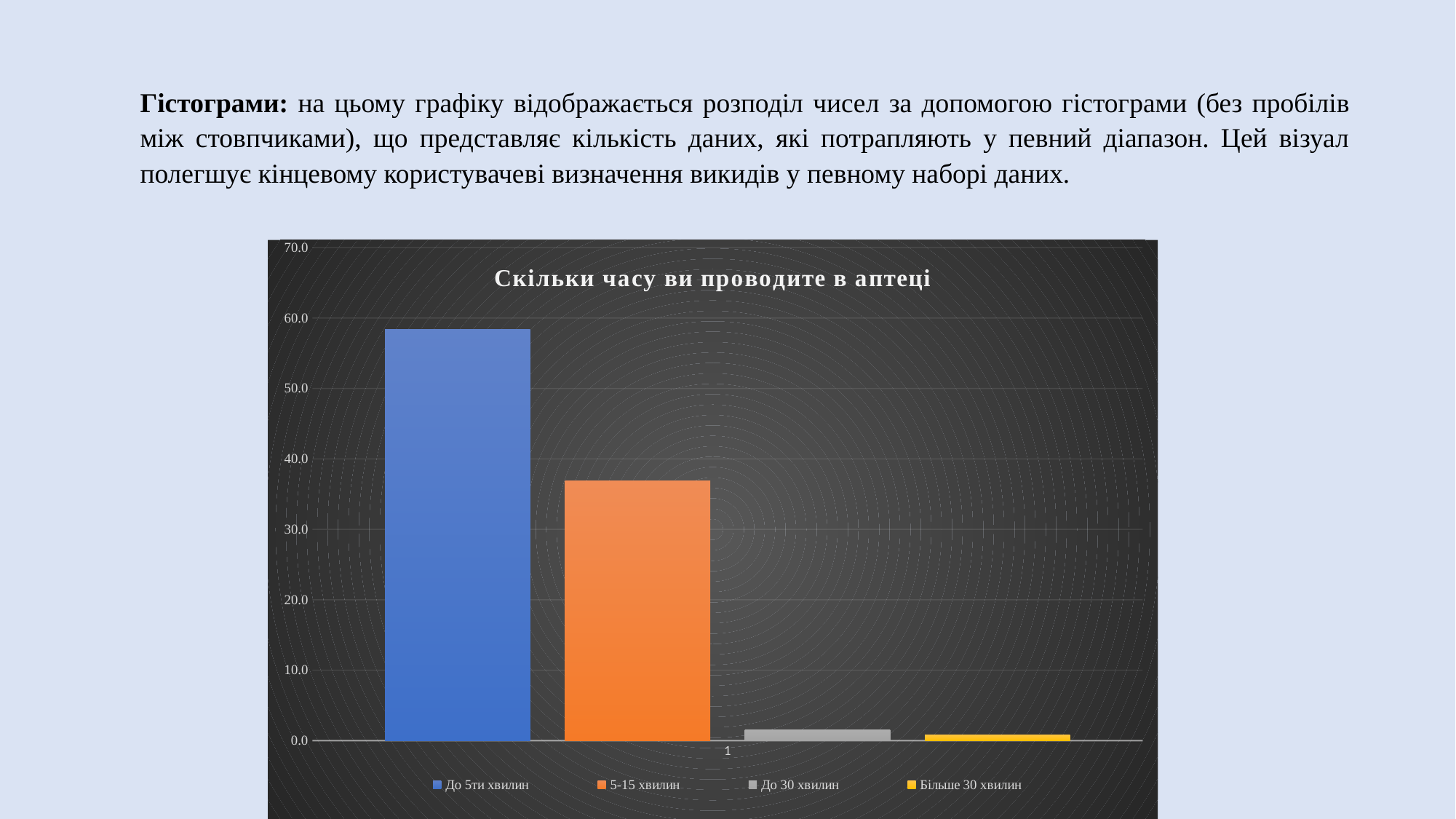
Which is larger, the value for До 5ти хвилин or the value for 5-15 хвилин? До 5ти хвилин What is the title of the chart? Скільки часу ви проводите в аптеці Is the value for 5-15 хвилин greater or less than 40.0? less How many series does the legend list? 4 Which series has the lowest value? Більше 30 хвилин Is the value for До 5ти хвилин greater or less than 50.0? greater How many bars are plotted in the chart? 4 Is the value for До 30 хвилин greater or less than 10.0? less Which is larger, the value for 5-15 хвилин or the value for До 30 хвилин? 5-15 хвилин Which series has the highest value? До 5ти хвилин What kind of chart is shown on the slide? bar chart Which colour represents the series 5-15 хвилин in the legend? orange